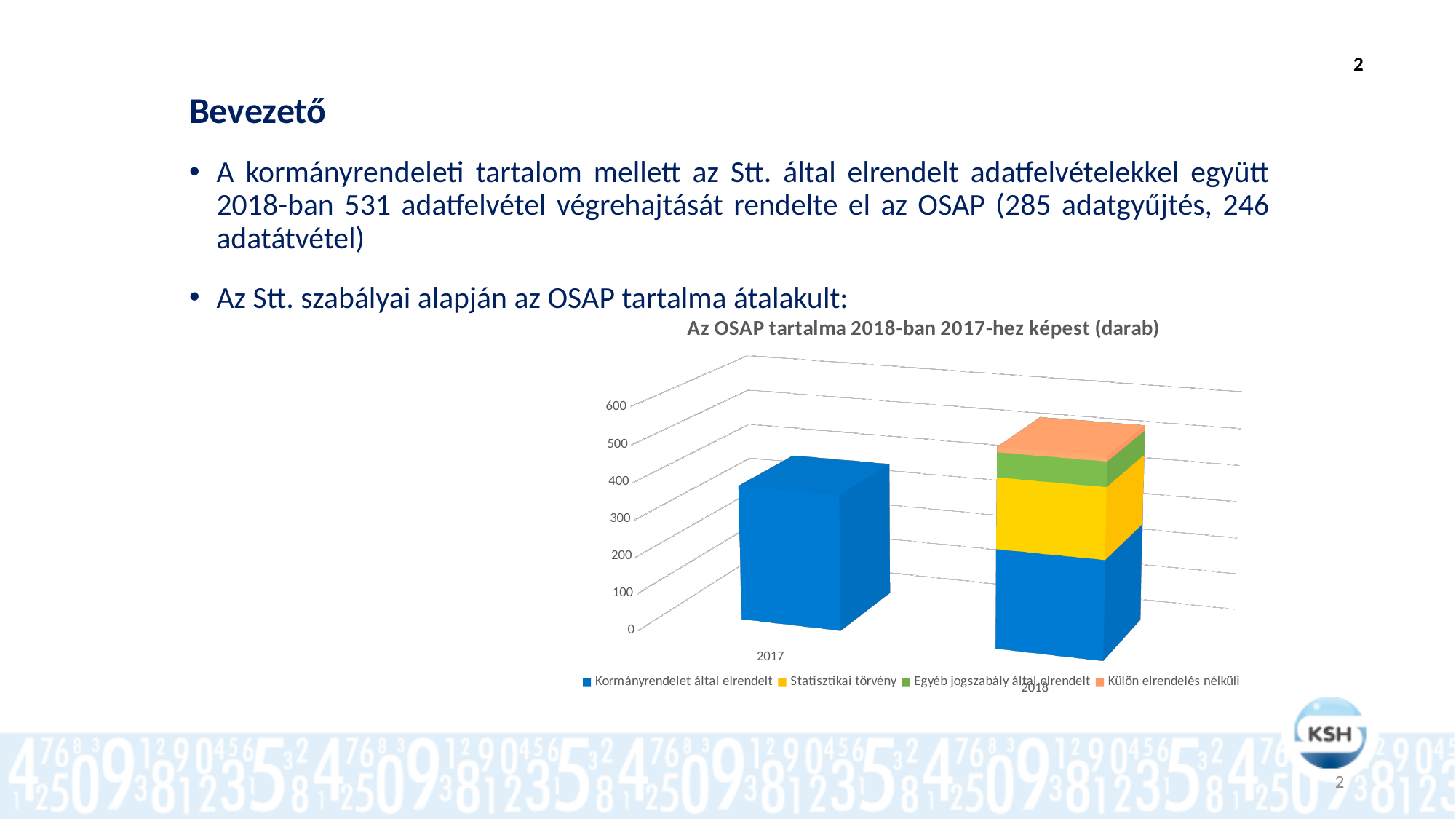
Is the value for 2017 greater or less than 300? greater Do the bar totals rise or fall from 2017 to 2018? rise How many series does the chart's legend list? 4 How many categories are shown on the x axis of the chart? 2 Is the value for 2017 greater or less than 500? less Is the total for 2018 greater or less than 600? less Which colour represents the series 'Statisztikai törvény' in the chart? Yellow Which year has the taller bar, 2017 or 2018? 2018 What is the title of the chart? Az OSAP tartalma 2018-ban 2017-hez képest (darab) Which category has the highest total bar? 2018 What kind of chart is shown on the slide? Stacked bar chart